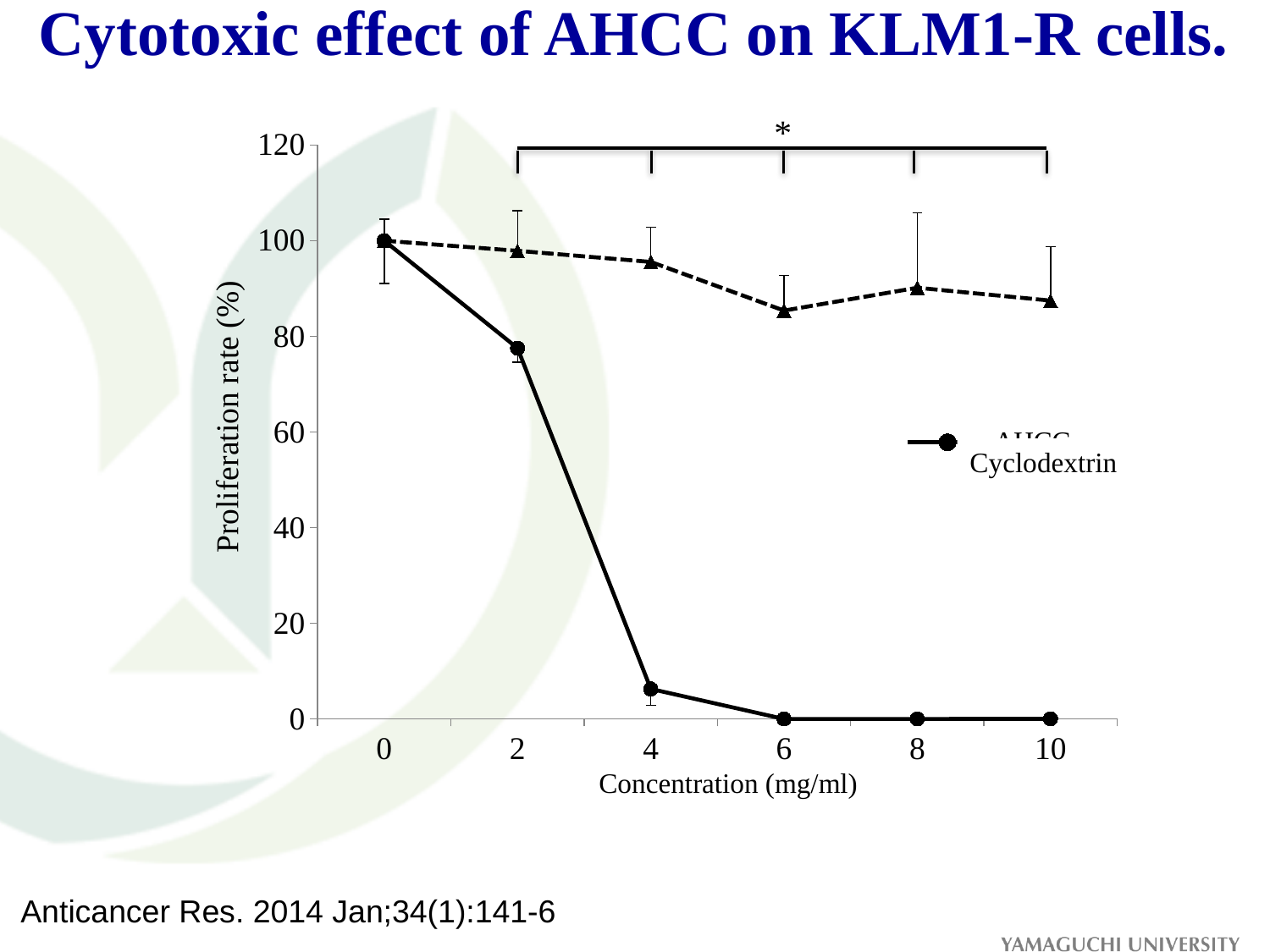
What is the label of the x axis? Concentration (mg/ml) Does the proliferation rate for AHCC rise or fall as concentration increases? Fall At a concentration of 4 mg/ml, which series has the higher proliferation rate, AHCC or Cyclodextrin? Cyclodextrin How many series does the legend list? 2 What kind of chart is shown on the slide? Line chart What is the proliferation rate for AHCC at a concentration of 10 mg/ml? 0 What is the proliferation rate for AHCC at a concentration of 0 mg/ml? 100 Is the proliferation rate for AHCC at 4 mg/ml greater or less than 20? less Is the proliferation rate for Cyclodextrin at 6 mg/ml greater or less than 80? greater Is the proliferation rate for AHCC at 2 mg/ml greater or less than 60? greater What is the proliferation rate for AHCC at a concentration of 6 mg/ml? 0 How many concentration points are plotted for each series? 6